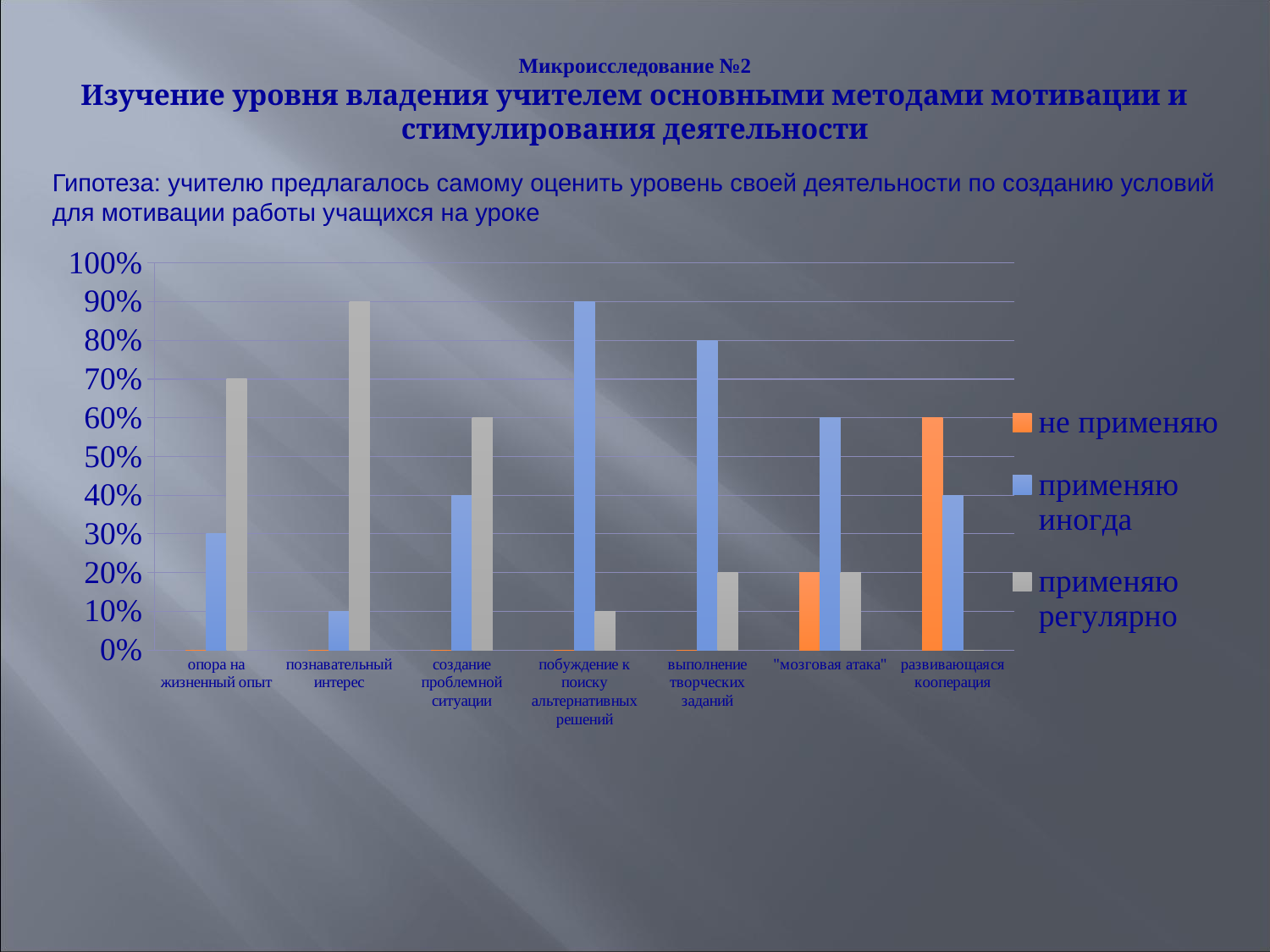
What type of chart is shown on the slide? bar chart How many series does the legend list? 3 Is the value of "применяю иногда" for "выполнение творческих заданий" greater or less than 50%? greater Which colour represents the "не применяю" series in the legend? orange Which is larger for "создание проблемной ситуации": "применяю иногда" or "применяю регулярно"? применяю регулярно Which category has the highest value for "применяю регулярно"? познавательный интерес What is the value of "применяю регулярно" for "познавательный интерес"? 90% What is the value of "применяю иногда" for "побуждение к поиску альтернативных решений"? 90% Which category has the highest value for "не применяю"? развивающаяся кооперация What is the difference between "применяю регулярно" and "применяю иногда" for "опора на жизненный опыт"? 40% How many categories are shown on the x axis? 7 What is the value of "не применяю" for "развивающаяся кооперация"? 60%